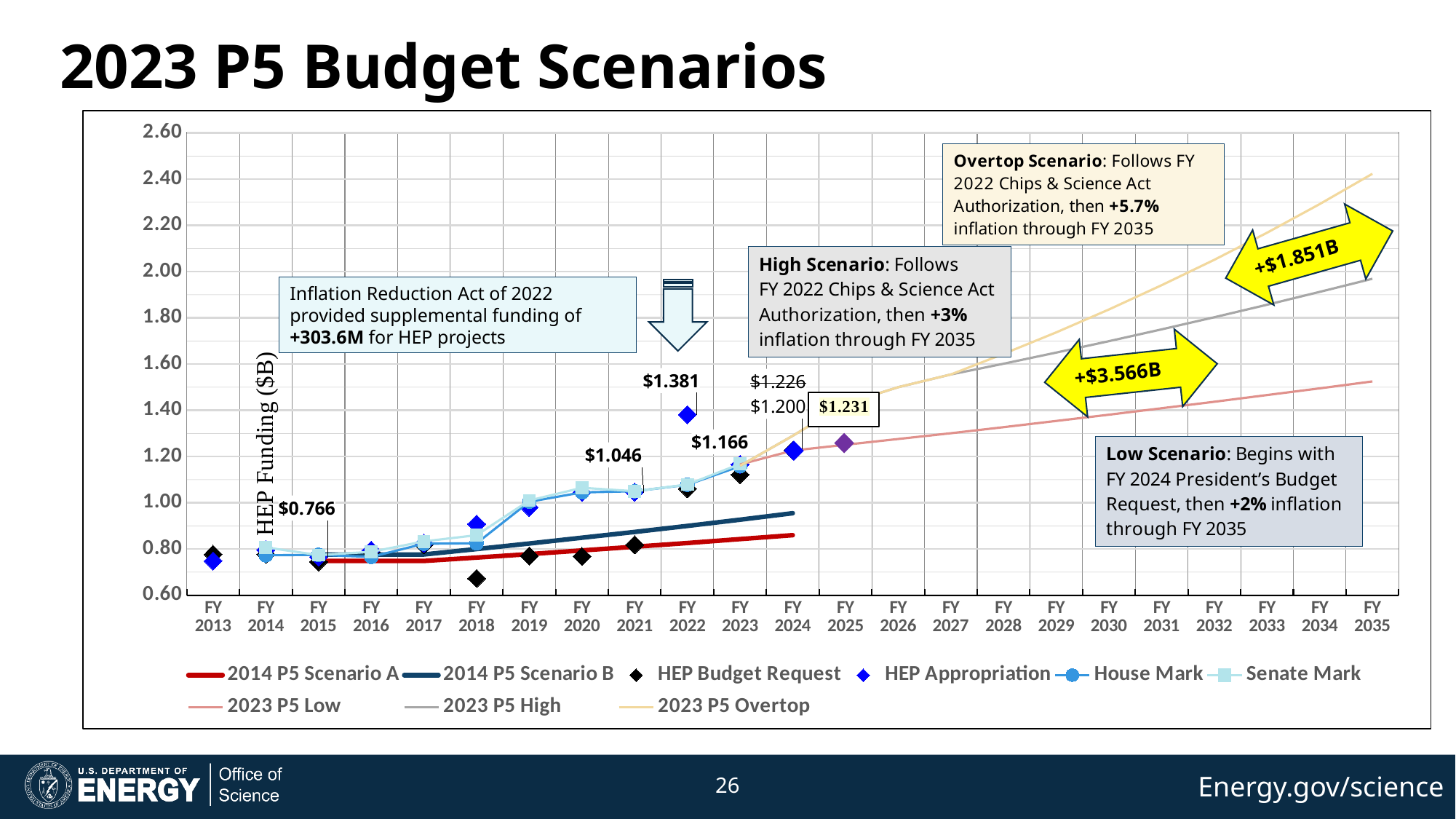
How many series does the legend list? 9 Which series reaches the highest value at FY 2035? 2023 P5 Overtop Which is larger, the labeled FY 2022 appropriation or the labeled FY 2023 value? FY 2022 What is the labeled value for FY 2023? $1.166 What kind of chart is shown on the slide? line chart Does the 2023 P5 Low line rise or fall from FY 2024 to FY 2035? rise How many fiscal years are shown on the x axis? 23 What is the difference between the labeled FY 2022 value ($1.381) and the labeled FY 2023 value ($1.166)? $0.215 Is the 2023 P5 Overtop value at FY 2035 greater or less than 2.20? greater What is the labeled HEP Appropriation value for FY 2022? $1.381 What is the label on the y axis? HEP Funding ($B) What is the labeled HEP Appropriation value for FY 2021? $1.046